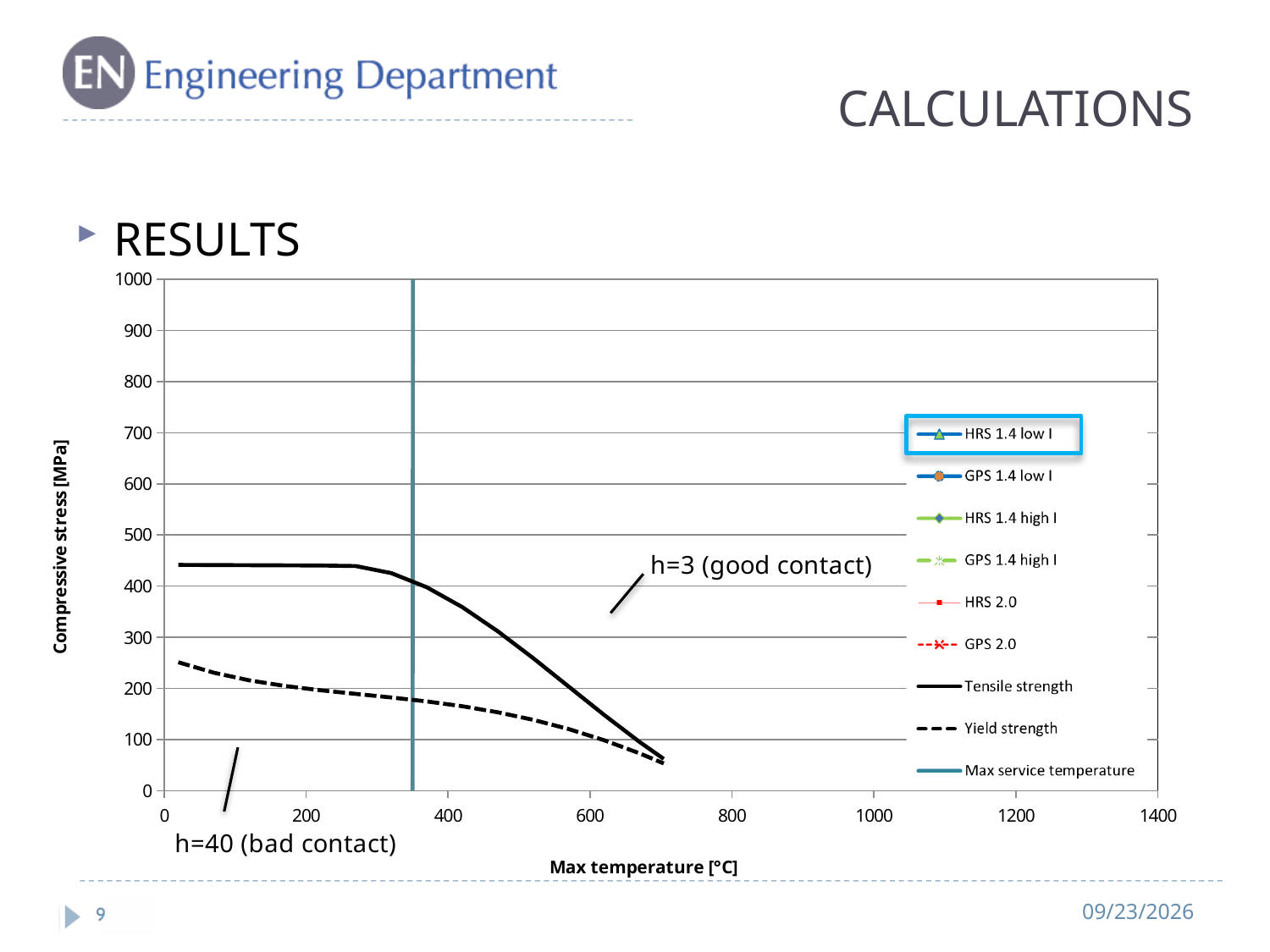
Does the Tensile strength curve rise or fall as Max temperature increases? fall Is the Tensile strength value at 200 °C greater or less than 400? greater Is the Yield strength value at 0 °C greater or less than 200? greater What is the title of the chart's y axis? Compressive stress [MPa] Is the Max service temperature line positioned at a temperature greater or less than 400 °C? less What is the title of the chart's x axis? Max temperature [°C] At 400 °C, which is larger: Tensile strength or Yield strength? Tensile strength What is the highest tick value shown on the x axis? 1400 How many series does the chart's legend list? 9 What kind of chart is shown on the slide? line chart